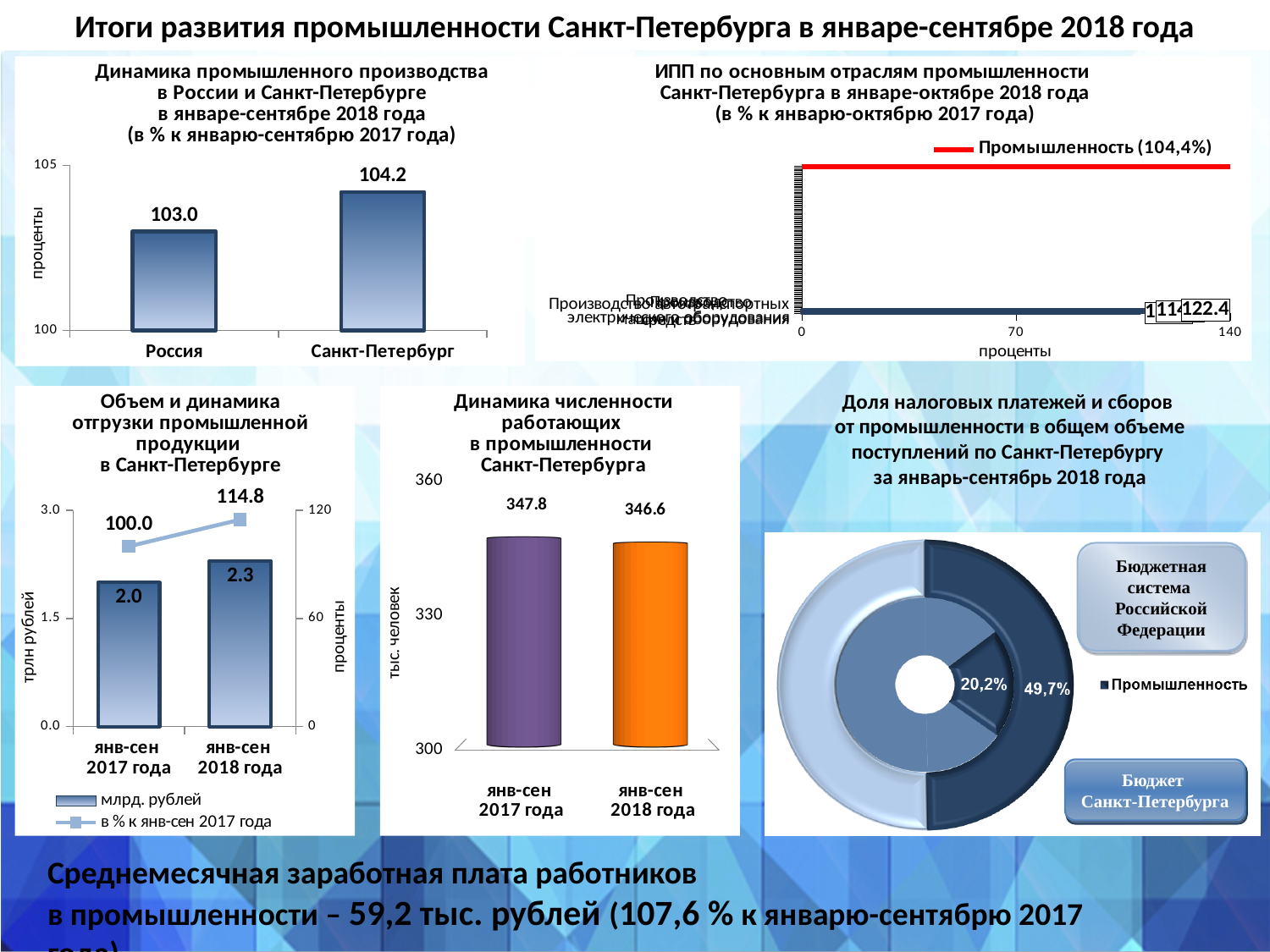
In the chart 'Динамика промышленного производства в России и Санкт-Петербурге', what is the difference between the values for Санкт-Петербург and Россия? 1.2 In the chart 'Объем и динамика отгрузки промышленной продукции в Санкт-Петербурге', what is the line value (в % к янв-сен 2017 года) for янв-сен 2018 года? 114.8 In the chart 'Динамика численности работающих в промышленности Санкт-Петербурга', what is the value for янв-сен 2017 года? 347.8 In the chart 'Динамика промышленного производства в России и Санкт-Петербурге', what is the value for Россия? 103.0 In the chart 'Динамика промышленного производства в России и Санкт-Петербурге', what is the value for Санкт-Петербург? 104.2 In the chart 'Динамика численности работающих в промышленности Санкт-Петербурга', do the values rise or fall from янв-сен 2017 года to янв-сен 2018 года? fall What kind of chart is 'Динамика численности работающих в промышленности Санкт-Петербурга'? bar chart In the chart 'ИПП по основным отраслям промышленности Санкт-Петербурга', what value is shown in the legend entry for Промышленность? 104,4% In the chart 'Динамика промышленного производства в России и Санкт-Петербурге', which category has the higher value? Санкт-Петербург How many series does the legend list in the chart 'Объем и динамика отгрузки промышленной продукции в Санкт-Петербурге'? 2 In the chart 'Объем и динамика отгрузки промышленной продукции в Санкт-Петербурге', what is the bar value for янв-сен 2018 года? 2.3 In the chart 'Динамика численности работающих в промышленности Санкт-Петербурга', what is the value for янв-сен 2018 года? 346.6